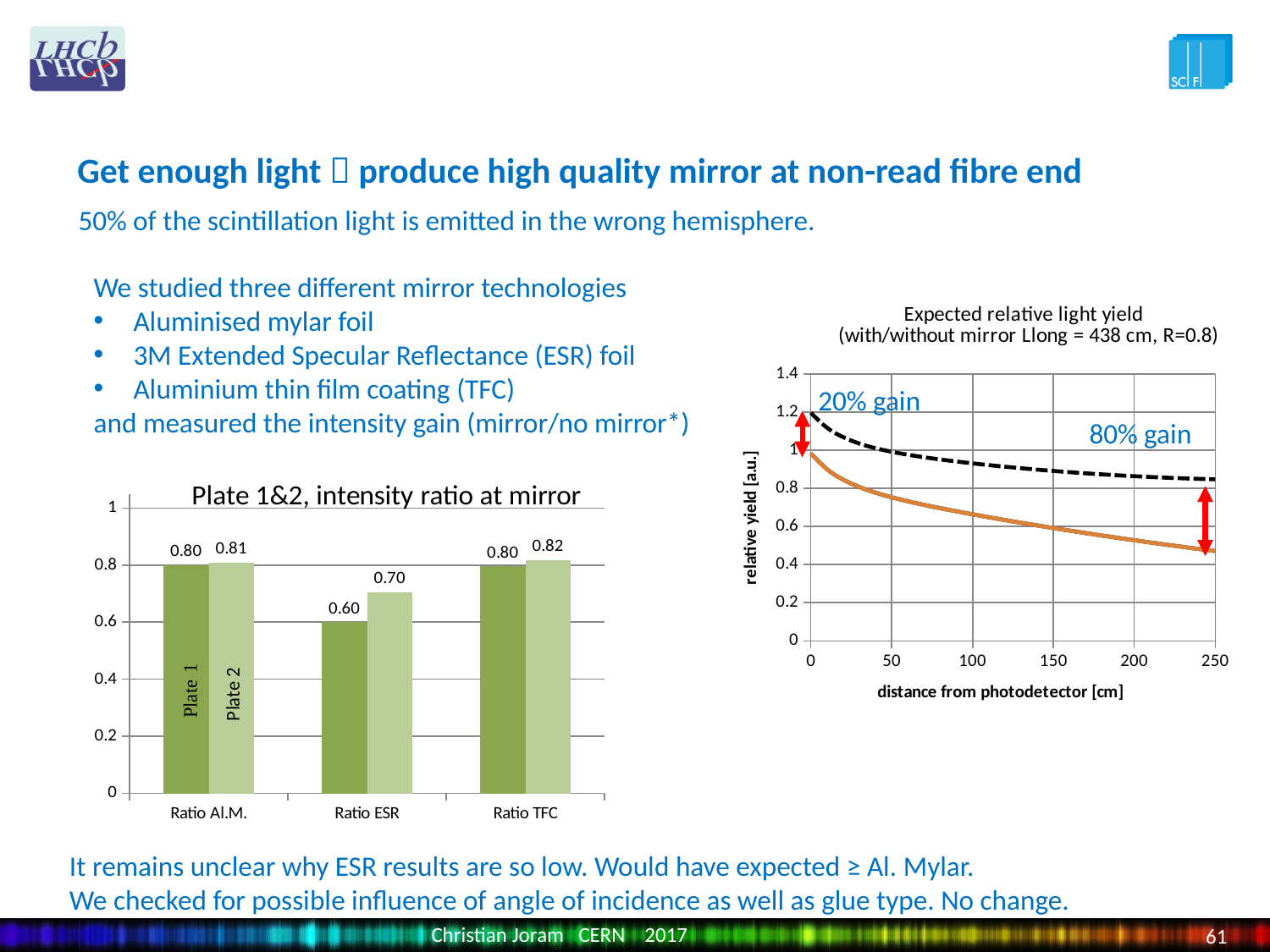
In the chart titled 'Plate 1&2, intensity ratio at mirror', what is the Plate 2 value for Ratio TFC? 0.82 In the chart titled 'Plate 1&2, intensity ratio at mirror', is the Plate 1 value for Ratio Al.M. or the Plate 1 value for Ratio ESR larger? Ratio Al.M. In the chart titled 'Expected relative light yield', do the values of the solid orange line rise or fall as the distance from photodetector increases? fall In the chart titled 'Plate 1&2, intensity ratio at mirror', which category has the lowest Plate 1 value? Ratio ESR In the chart titled 'Expected relative light yield', is the value of the solid orange line at 250 cm greater or less than 0.6? less In the chart titled 'Plate 1&2, intensity ratio at mirror', what is the Plate 1 value for Ratio ESR? 0.60 What kind of chart is 'Plate 1&2, intensity ratio at mirror'? bar chart In the chart titled 'Plate 1&2, intensity ratio at mirror', what is the difference between the Plate 2 and Plate 1 values for Ratio ESR? 0.10 In the chart titled 'Plate 1&2, intensity ratio at mirror', which category has the highest Plate 2 value? Ratio TFC How many categories are shown on the x axis of the chart titled 'Plate 1&2, intensity ratio at mirror'? 3 What is the x-axis label of the chart titled 'Expected relative light yield'? distance from photodetector [cm] In the chart titled 'Plate 1&2, intensity ratio at mirror', what is the Plate 2 value for Ratio Al.M.? 0.81